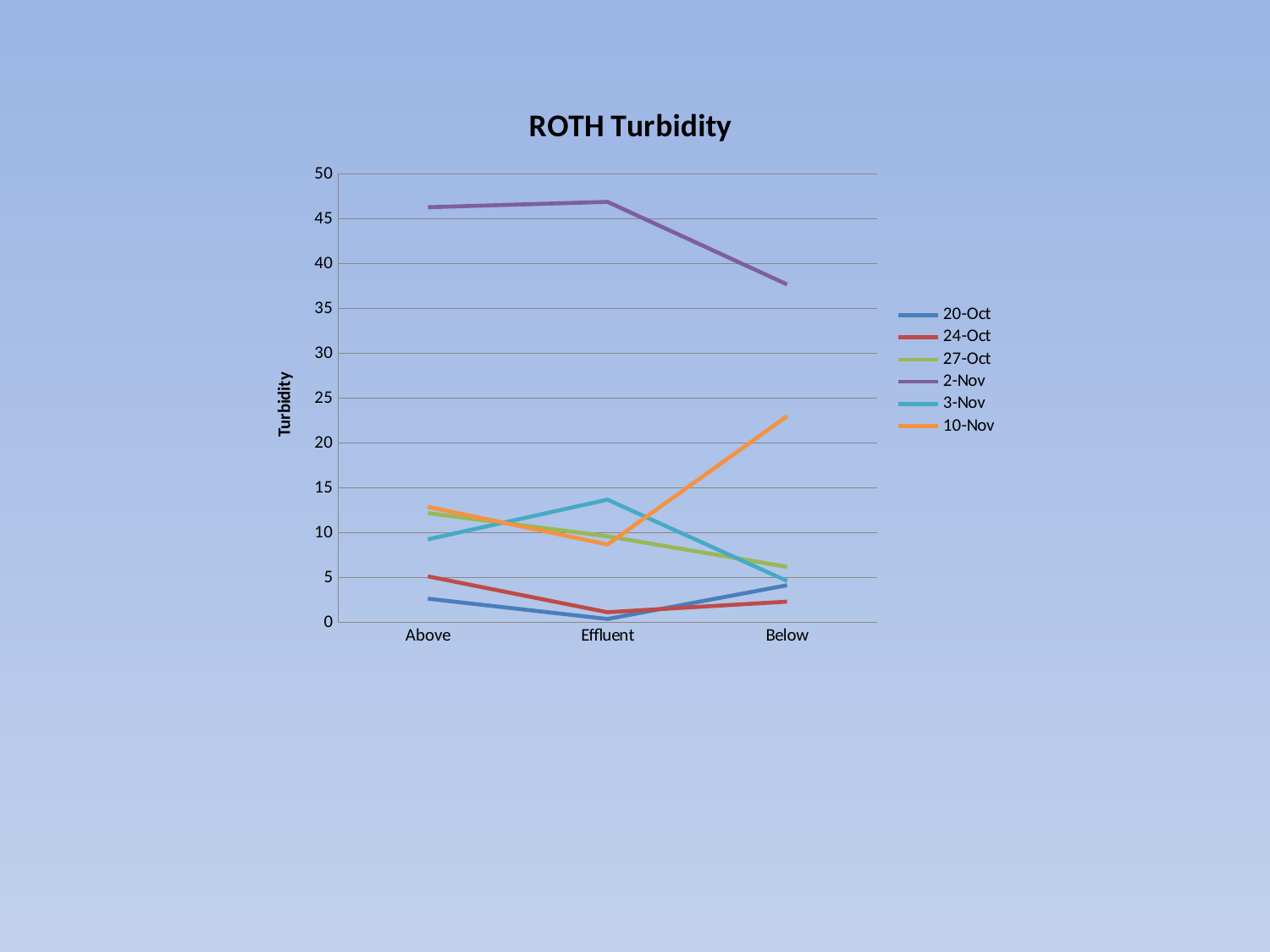
Does the 2-Nov line rise or fall from Effluent to Below? fall What is the title of the chart? ROTH Turbidity At Below, which is larger: 10-Nov or 27-Oct? 10-Nov Is the value for 3-Nov at Effluent greater or less than 10? greater Is the value for 2-Nov at Below greater or less than 40? less How many series does the legend list? 6 What kind of chart is shown on the slide? line chart Is the value for 10-Nov at Below greater or less than 20? greater How many categories are shown on the x axis? 3 Which series has the highest turbidity at Above? 2-Nov Which series has the lowest turbidity at Above? 20-Oct Does the 10-Nov line rise or fall from Effluent to Below? rise